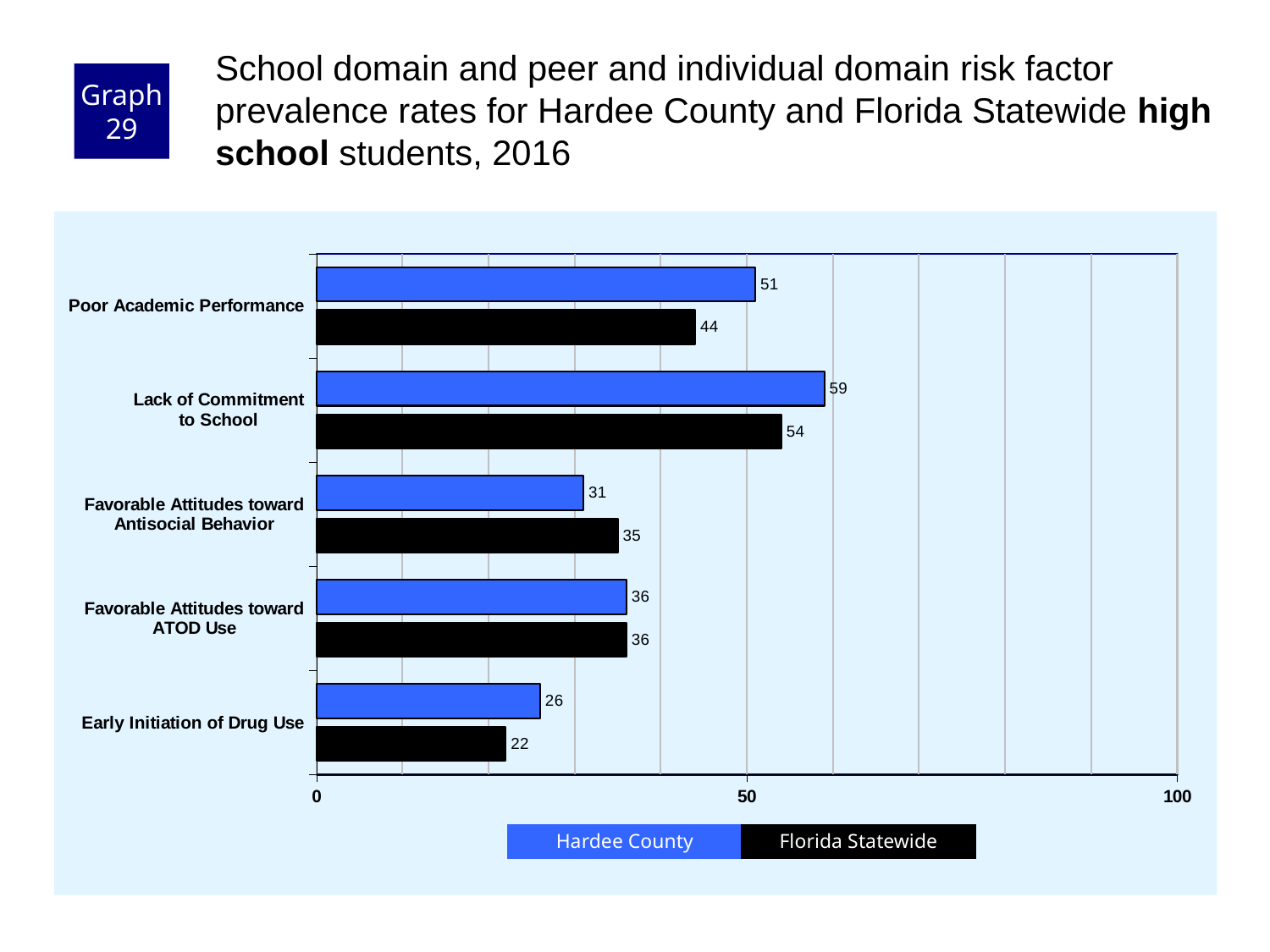
What is the Hardee County value for Poor Academic Performance? 51 What kind of chart is shown on the slide? bar chart Is the Hardee County value for Lack of Commitment to School greater or less than 50? greater What is the Florida Statewide value for Lack of Commitment to School? 54 Which risk factor has the highest Hardee County value? Lack of Commitment to School What is the difference between the Hardee County and Florida Statewide values for Poor Academic Performance? 7 How many series does the legend list? 2 What is the Hardee County value for Early Initiation of Drug Use? 26 What colour are the Florida Statewide bars? black Which risk factor has the lowest Florida Statewide value? Early Initiation of Drug Use How many risk factor categories are shown on the chart? 5 For Favorable Attitudes toward Antisocial Behavior, which is larger: the Hardee County value or the Florida Statewide value? Florida Statewide